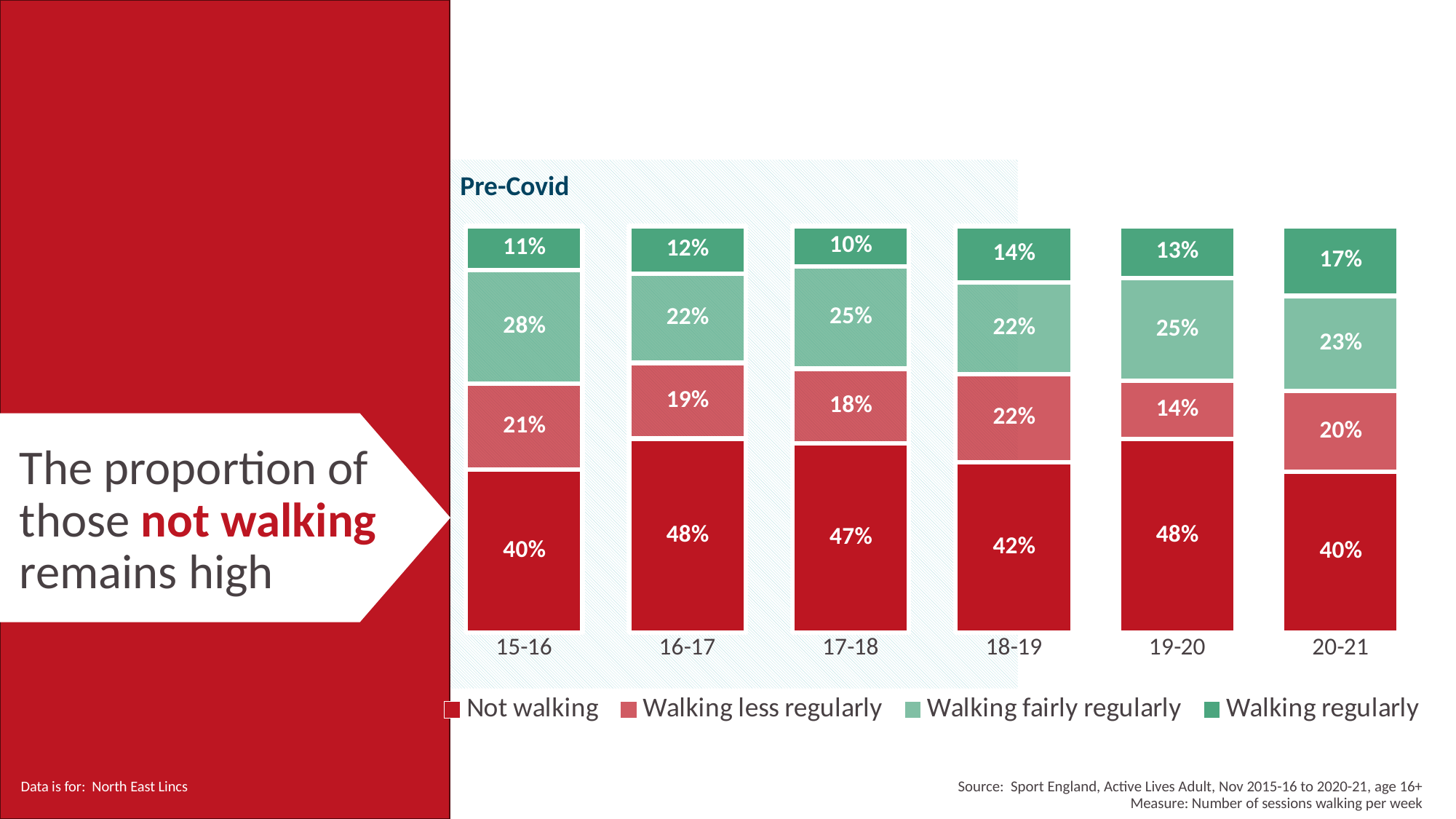
What percentage were not walking in 20-21? 40% In which year was the 'Walking regularly' share highest? 20-21 How many years are shown on the x axis? 6 Which is larger: the 'Walking fairly regularly' share in 17-18 or in 16-17? 17-18 What kind of chart is shown? Stacked bar chart Which years are grouped under the 'Pre-Covid' label? 15-16, 16-17, 17-18, 18-19 What percentage were walking regularly in 18-19? 14% What is the difference between the 'Not walking' share in 16-17 and in 15-16? 8 percentage points In which year was the 'Walking regularly' share lowest? 17-18 What percentage were walking fairly regularly in 15-16? 28% What percentage were walking less regularly in 19-20? 14% How many series does the legend list? 4